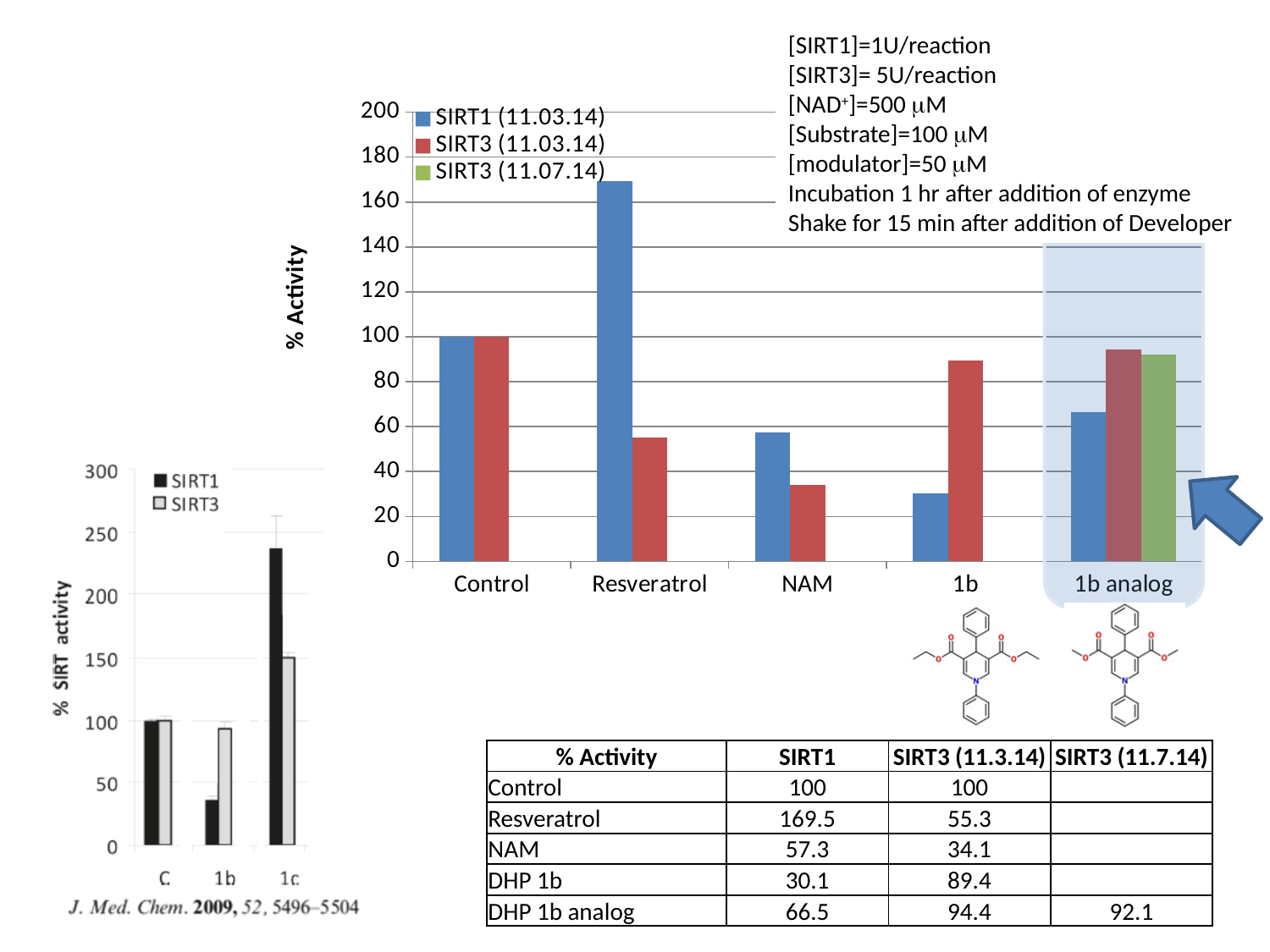
In the large '% Activity' chart, how many categories are shown on the x axis? 5 In the large '% Activity' chart, which category has the lowest SIRT1 (11.03.14) value? 1b What kind of chart is the large chart titled with the y-axis '% Activity'? bar chart In the large '% Activity' chart, which category has the highest SIRT1 (11.03.14) value? Resveratrol In the large '% Activity' chart, is the SIRT1 (11.03.14) value for Resveratrol greater or less than 140? greater According to the table on the slide, what is the SIRT1 % Activity for Resveratrol? 169.5 In the small chart at the bottom left from J. Med. Chem. 2009, which category has the highest SIRT1 value? 1c According to the table on the slide, what is the difference between the SIRT3 (11.3.14) and SIRT3 (11.7.14) values for DHP 1b analog? 2.3 In the large '% Activity' chart, what is the SIRT1 (11.03.14) value for Control? 100 In the large '% Activity' chart, for the 1b category, which is larger: the SIRT1 (11.03.14) bar or the SIRT3 (11.03.14) bar? SIRT3 (11.03.14) In the large '% Activity' chart, is the SIRT3 (11.03.14) value for NAM greater or less than 40? less In the large '% Activity' chart, how many series does the legend list? 3